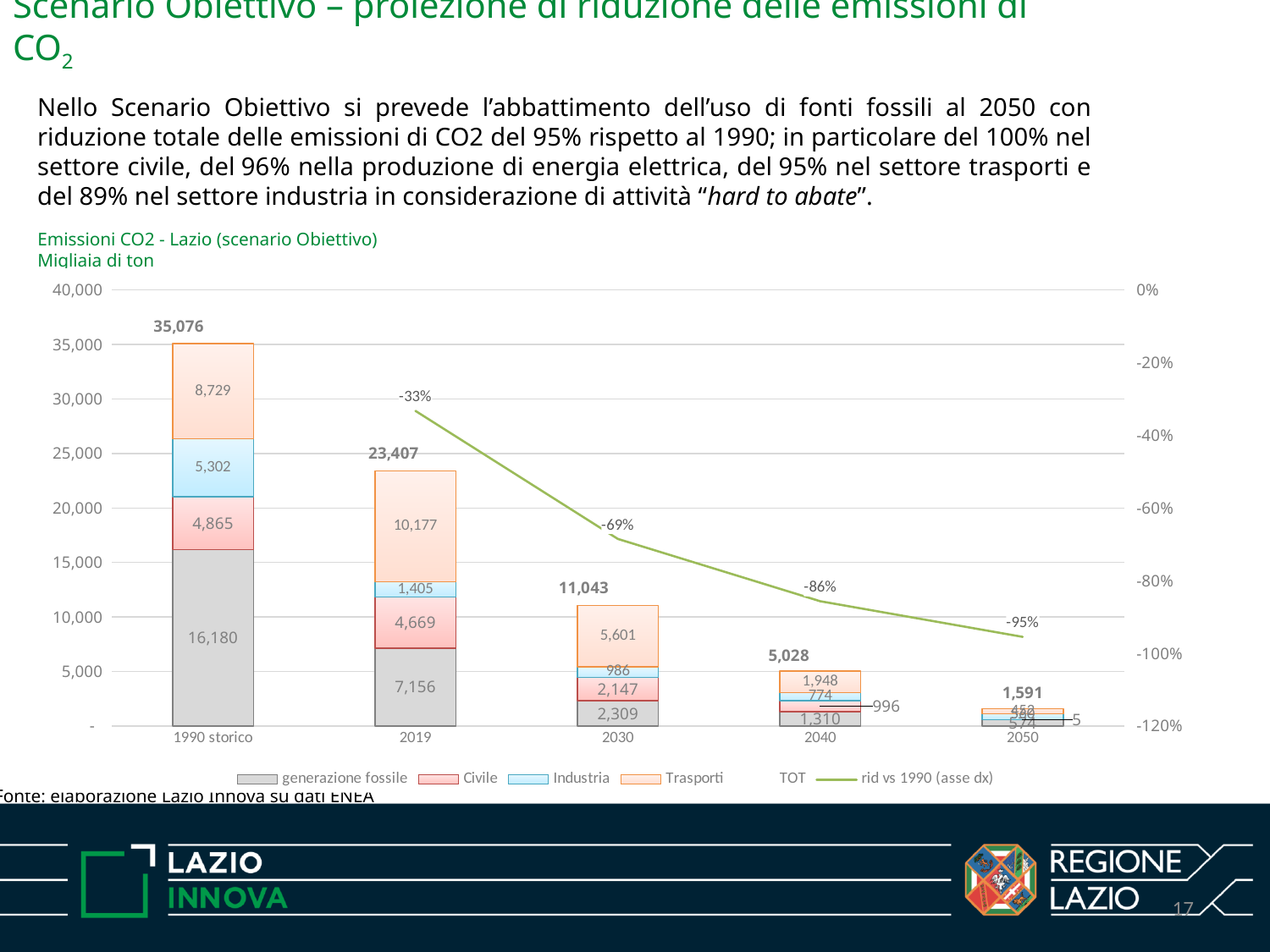
What is the total emissions value shown above the 1990 storico bar? 35,076 How many series does the legend list? 6 What is the rid vs 1990 percentage shown for 2050? -95% Which is larger, the Trasporti value in 1990 storico or in 2019? 2019 What is the value of generazione fossile for 1990 storico? 16,180 What is the difference between the total emissions in 1990 storico and in 2019? 11,669 What is the rid vs 1990 percentage shown for 2030? -69% Which year has the highest total emissions? 1990 storico How many years (categories) are shown on the x axis? 5 Which year has the lowest total emissions? 2050 What is the value of Trasporti in 2019? 10,177 What is the value of Civile in 2030? 2,147